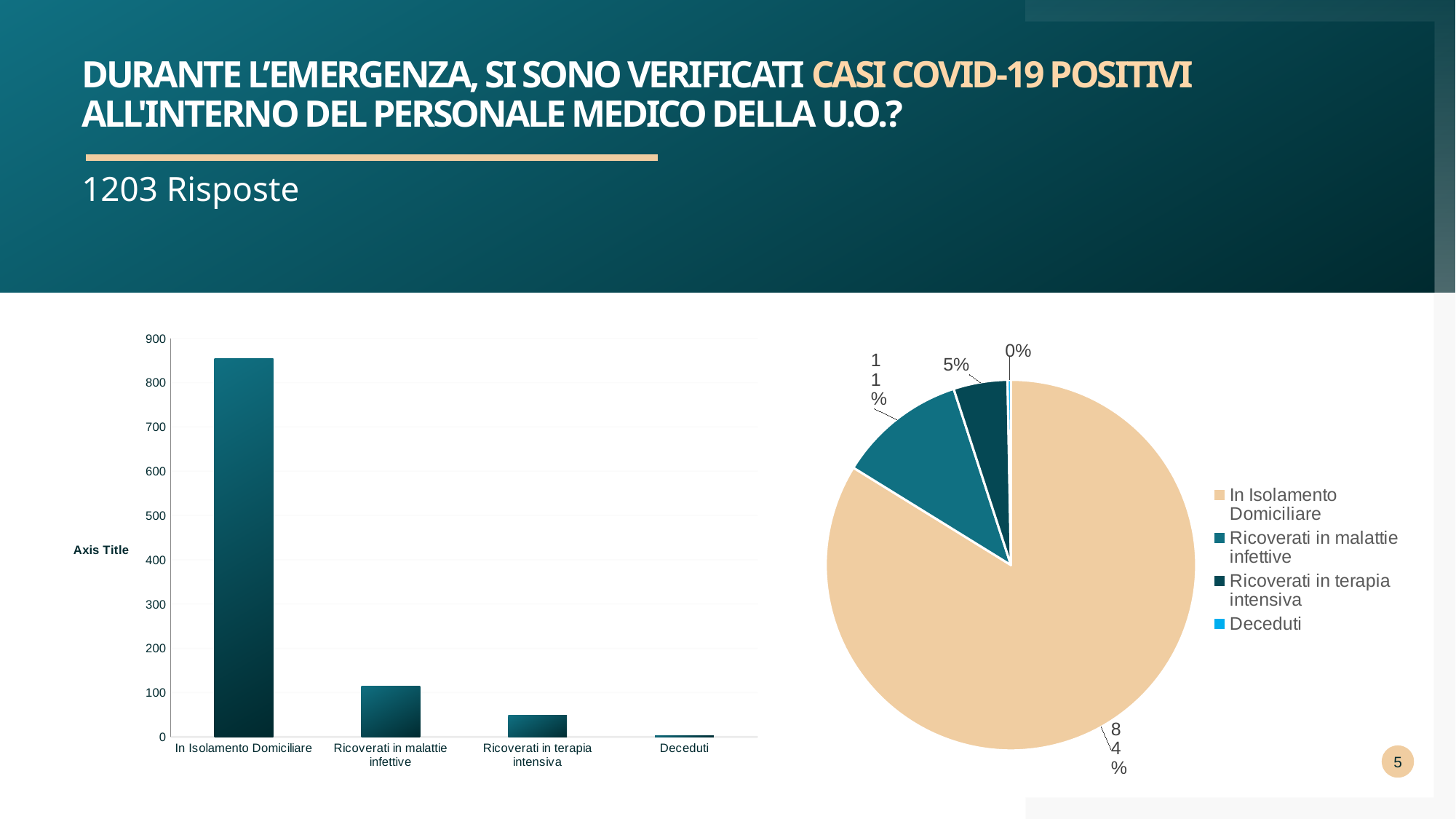
In the bar chart on the left, is the value for In Isolamento Domiciliare greater or less than 800? greater What kind of chart is the chart on the left of the slide? bar chart In the bar chart on the left, which category has the highest bar? In Isolamento Domiciliare In the bar chart on the left, is the value for Ricoverati in malattie infettive greater or less than 200? less In the pie chart on the right, what share does Ricoverati in terapia intensiva have? 5% In the pie chart on the right, how many entries does the legend list? 4 What kind of chart is the chart on the right of the slide? pie chart In the bar chart on the left, which category has the lowest bar? Deceduti In the bar chart on the left, how many categories are shown on the x axis? 4 In the bar chart on the left, which is larger: the bar for Ricoverati in malattie infettive or the bar for Ricoverati in terapia intensiva? Ricoverati in malattie infettive In the pie chart on the right, what share does In Isolamento Domiciliare have? 84% In the bar chart on the left, is the value for Ricoverati in terapia intensiva greater or less than 100? less